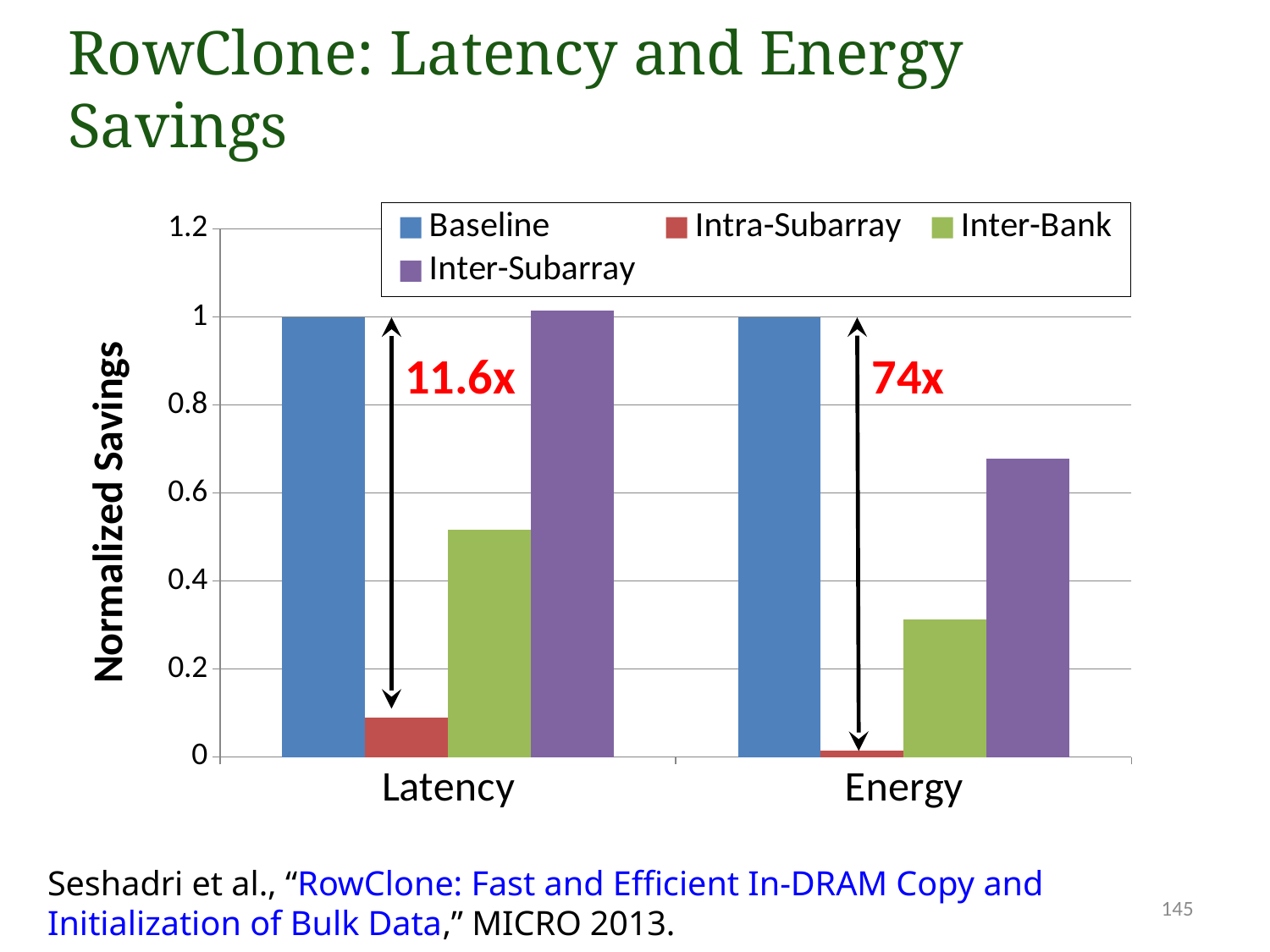
How many series does the legend list? 4 Which series has the lowest value for Energy? Intra-Subarray What is the title of the y axis? Normalized Savings Which series has the lowest value for Latency? Intra-Subarray For Latency, which is larger: Inter-Bank or Inter-Subarray? Inter-Subarray Is the Inter-Subarray value for Energy greater or less than 0.6? greater How many categories are shown on the x axis? 2 Is the Inter-Bank value for Energy greater or less than 0.4? less What kind of chart is shown on the slide? bar chart What is the Baseline value for Energy? 1 What is the Baseline value for Latency? 1 Which series has the highest value for Energy? Baseline